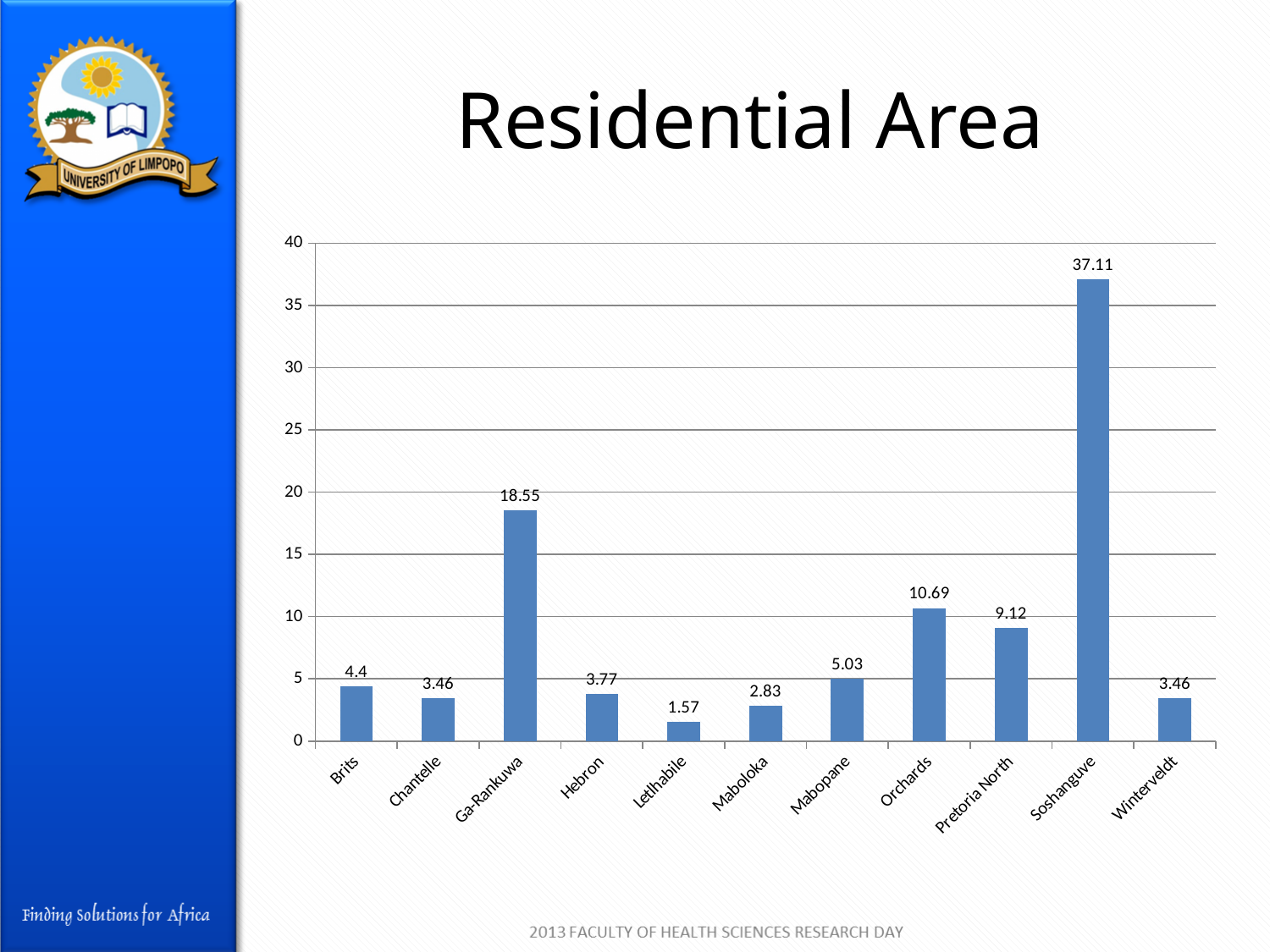
Which residential area has the highest value? Soshanguve Is the value for Orchards greater or less than 10? greater What is the difference between the values for Soshanguve and Ga-Rankuwa? 18.56 What is the value for Ga-Rankuwa? 18.55 Which residential area has the lowest value? Letlhabile What kind of chart is shown on the slide? Bar chart What is the value for Soshanguve? 37.11 How many residential areas are shown on the chart? 11 What is the difference between the values for Orchards and Pretoria North? 1.57 Which is larger, the value for Mabopane or the value for Maboloka? Mabopane What is the title of the slide? Residential Area What is the value for Letlhabile? 1.57